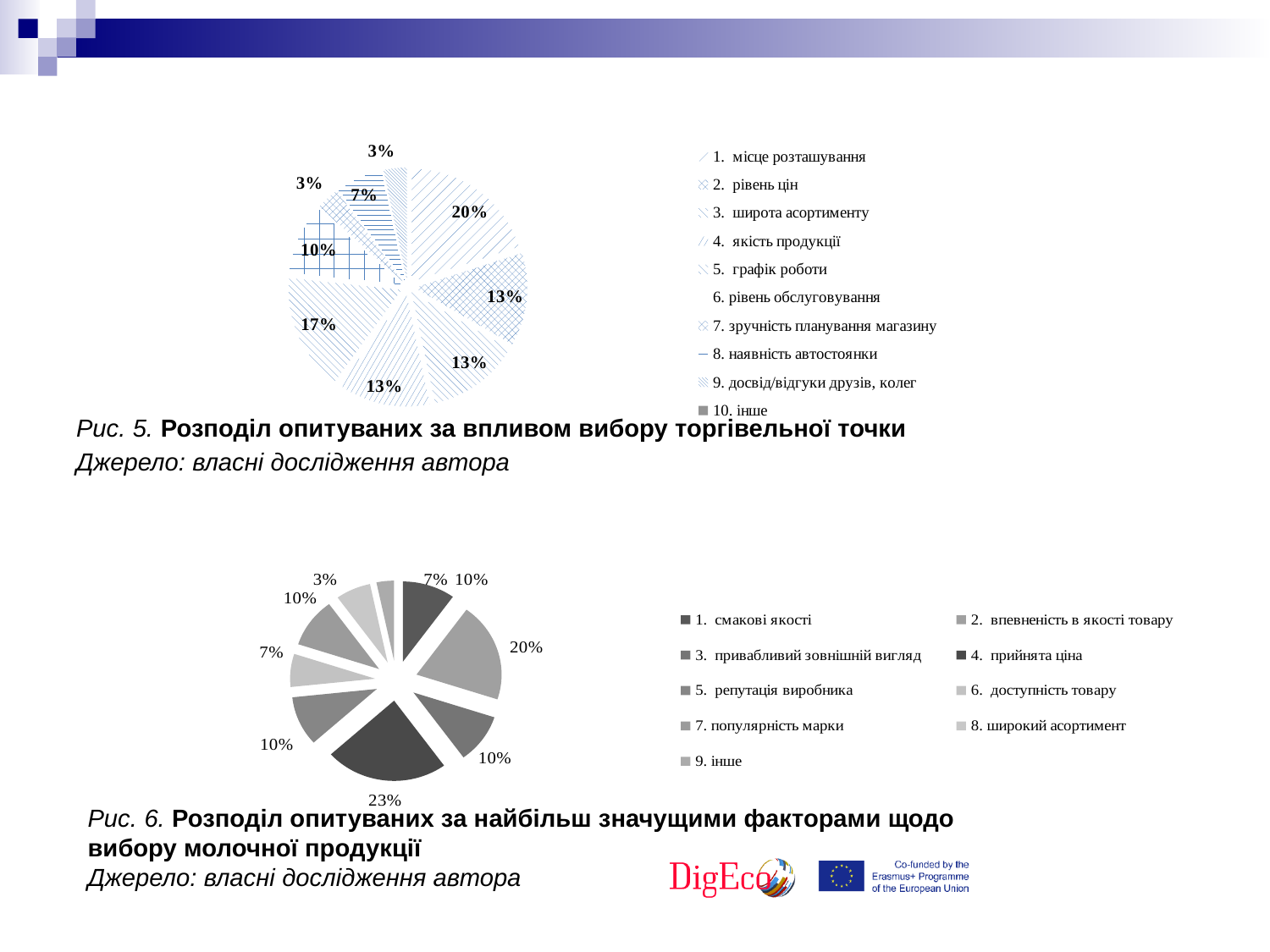
How many entries does the legend of the bottom chart (Рис. 6) list? 9 How many entries does the legend of the top chart (Рис. 5) list? 10 What kind of chart is the bottom chart (Рис. 6)? pie chart In the top chart (Рис. 5), what is the value of the largest slice? 20% In the top chart (Рис. 5), what is the value of the smallest slice? 3% In the top chart (Рис. 5), how many slices are labelled 13%? 3 In the bottom chart (Рис. 6), what is the value of the largest slice? 23% In the bottom chart (Рис. 6), what is the difference between the 23% slice and the 20% slice? 3 percentage points In the bottom chart (Рис. 6), what is the value of the smallest slice? 3% What kind of chart is the top chart (Рис. 5)? pie chart In the bottom chart (Рис. 6), how many slices are labelled 10%? 4 In the top chart (Рис. 5), what is the difference between the 20% slice and the 17% slice? 3 percentage points